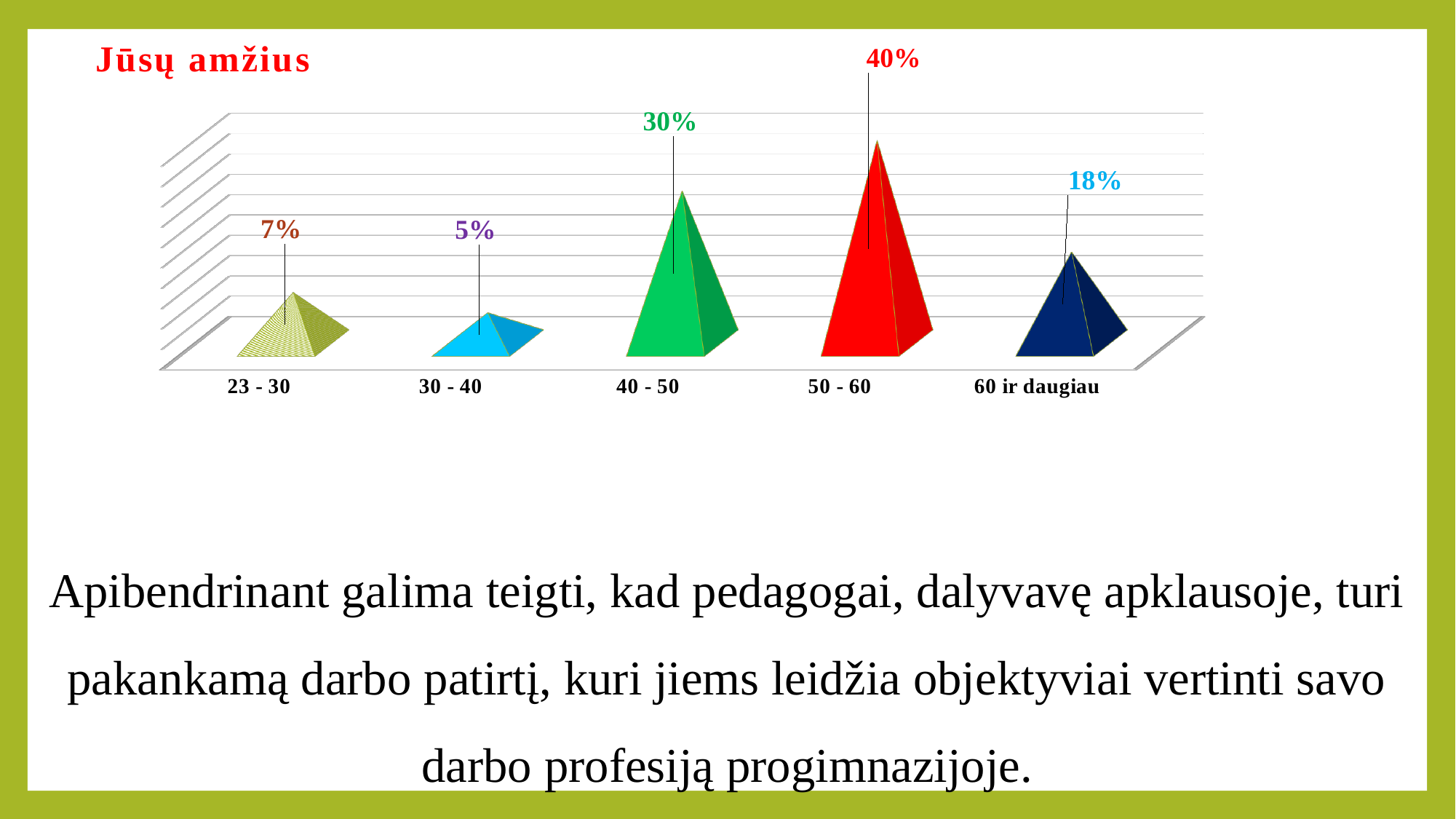
What is the title of the chart? Jūsų amžius What is the difference between the values for 60 ir daugiau and 30 - 40? 13% Which is larger, the value for 23 - 30 or the value for 30 - 40? 23 - 30 What is the value for the 50 - 60 age group? 40% What is the value for the 60 ir daugiau age group? 18% What is the value for the 23 - 30 age group? 7% What is the difference between the values for 50 - 60 and 40 - 50? 10% What colour is the bar for the 50 - 60 age group? red What kind of chart is shown on the slide? bar chart Which age group has the highest value? 50 - 60 How many age groups are shown on the chart? 5 Which age group has the lowest value? 30 - 40